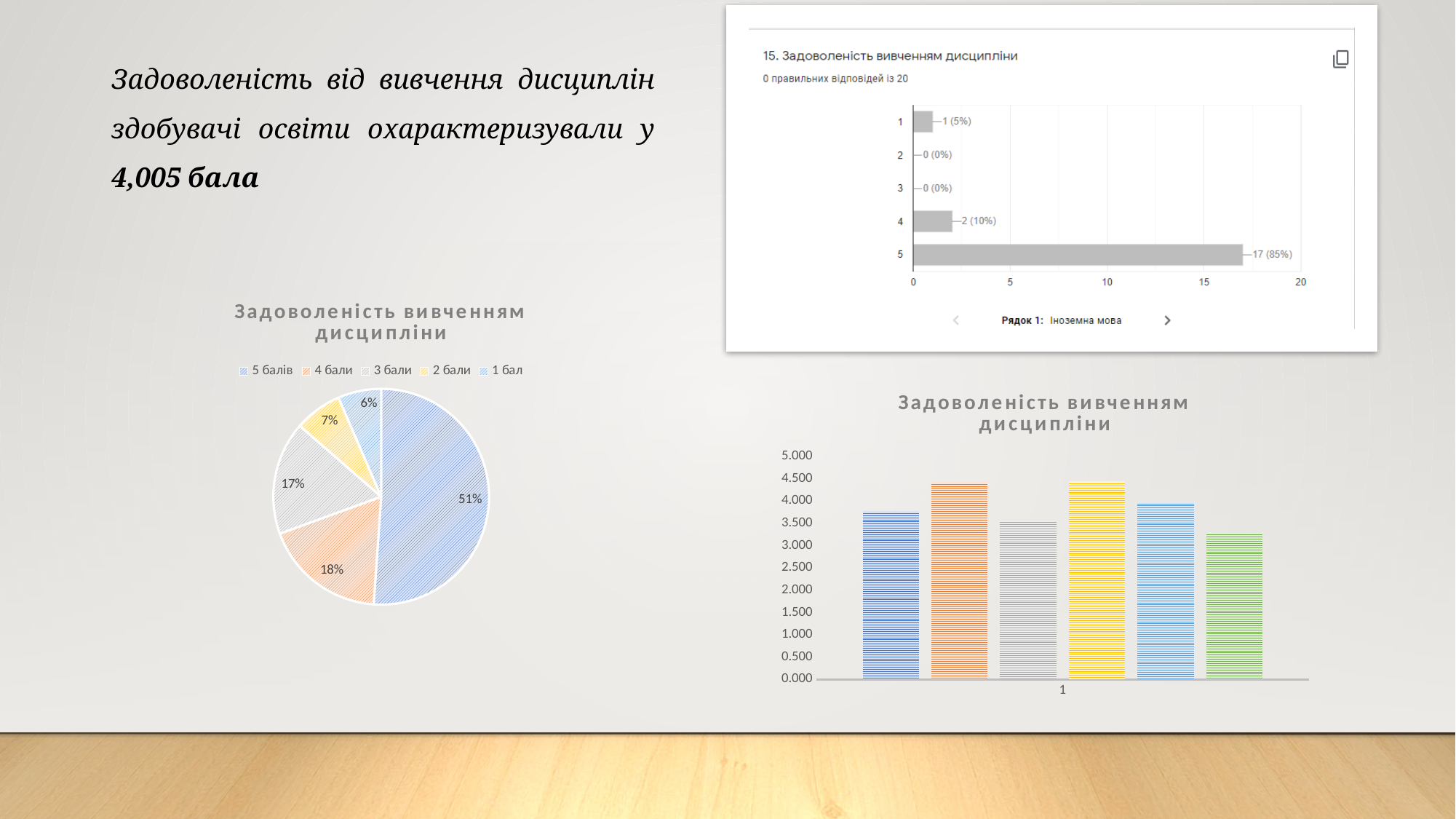
In the bar chart at the bottom right titled 'Задоволеність вивченням дисципліни', how many bars are plotted? 6 In the pie chart titled 'Задоволеність вивченням дисципліни', what share does '3 бали' have? 17% In the bar chart at the bottom right titled 'Задоволеність вивченням дисципліни', is the value of the green bar greater or less than 3.500? less In the pie chart titled 'Задоволеність вивченням дисципліни', what is the difference in percentage points between '4 бали' and '2 бали'? 11 In the screenshot chart at the top right ('15. Задоволеність вивченням дисципліни'), what is the value for category 5? 17 (85%) In the screenshot chart at the top right ('15. Задоволеність вивченням дисципліни'), what is the value for category 4? 2 (10%) In the pie chart titled 'Задоволеність вивченням дисципліни', which category has the smallest slice? 1 бал In the screenshot chart at the top right ('15. Задоволеність вивченням дисципліни'), what kind of chart is shown? bar chart In the pie chart titled 'Задоволеність вивченням дисципліни', which category has the largest slice? 5 балів In the screenshot chart at the top right ('15. Задоволеність вивченням дисципліни'), which category has the highest count? 5 In the pie chart titled 'Задоволеність вивченням дисципліни', how many categories does the legend list? 5 In the pie chart titled 'Задоволеність вивченням дисципліни', what share does '5 балів' have? 51%